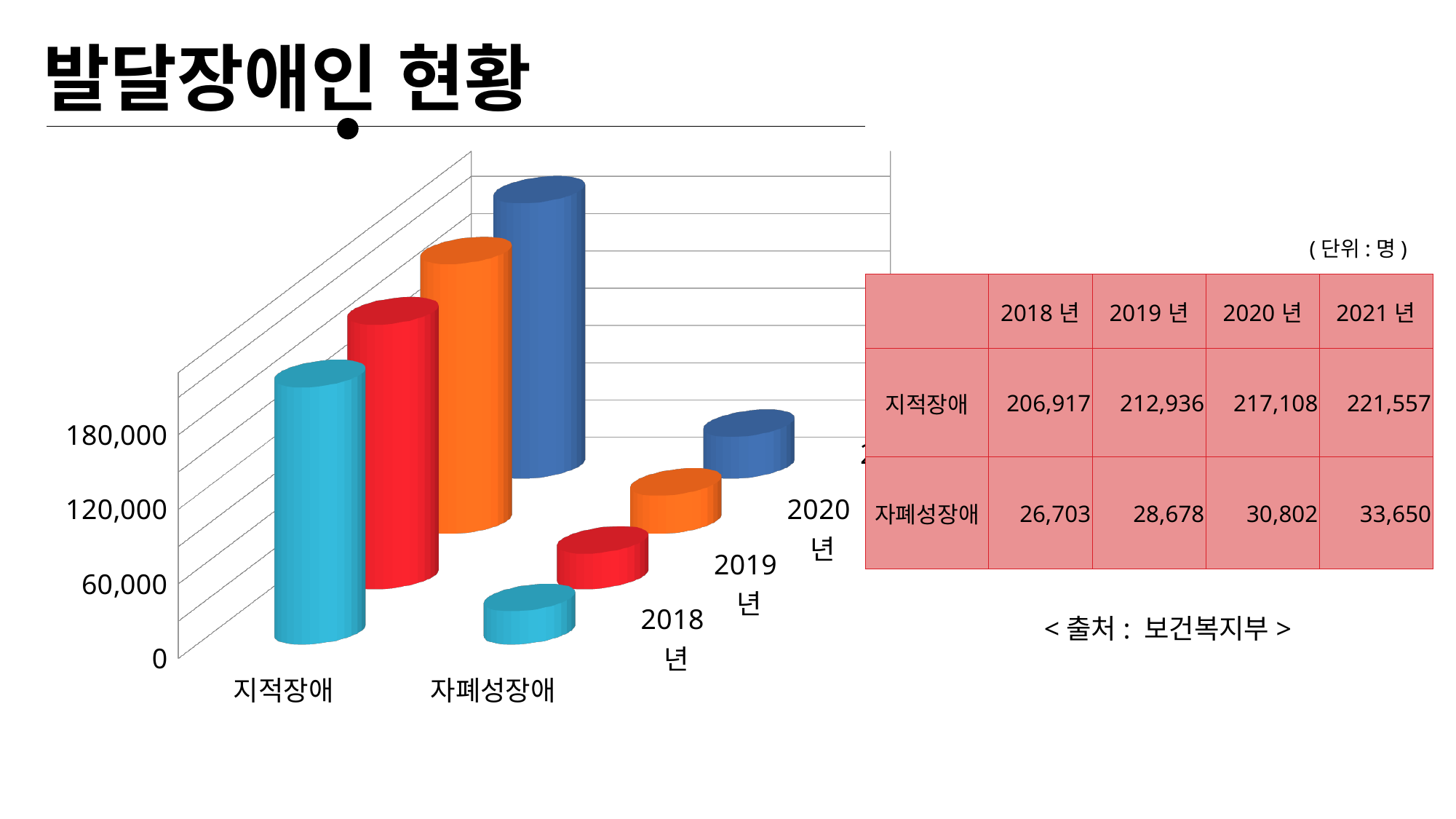
What unit is stated for the values in the table? 명 According to the table, what is the value for 지적장애 in 2018년? 206,917 How many disability categories are shown on the chart's category axis? 2 In which year is the value for 지적장애 the highest? 2021년 According to the table, what is the value for 자폐성장애 in 2021년? 33,650 How many bars are plotted for 지적장애 in the chart? 4 Do the values for 자폐성장애 rise or fall from 2018년 to 2021년? rise What is the difference between the 지적장애 values for 2021년 and 2018년? 14,640 Which is larger in 2020년, 지적장애 or 자폐성장애? 지적장애 Is the bar for 지적장애 in 2018년 greater or less than 180,000? greater What kind of chart is shown on the slide? bar chart In which year is the value for 자폐성장애 the lowest? 2018년